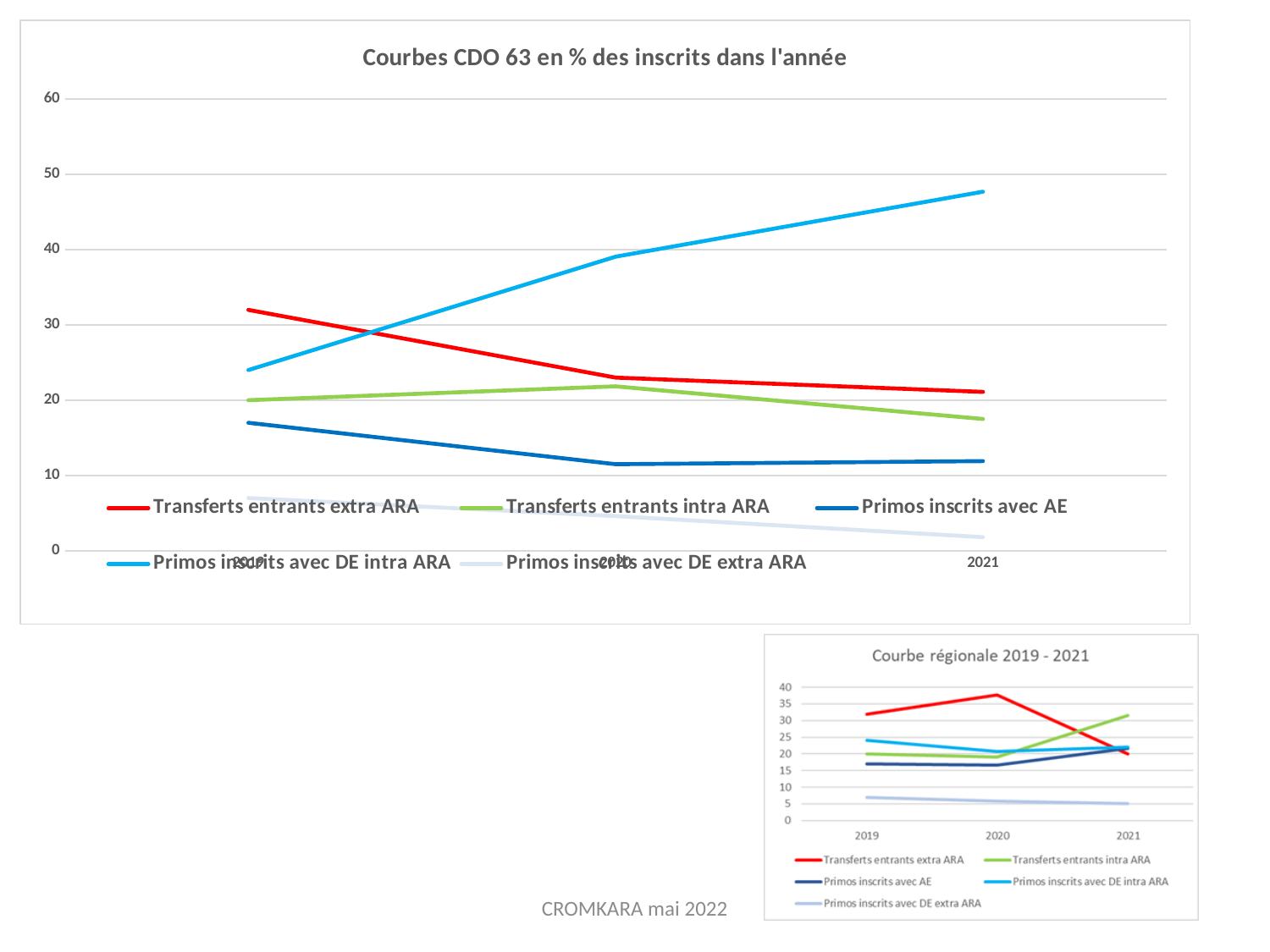
In the small chart 'Courbe régionale 2019 - 2021', which series has the highest value in 2021? Transferts entrants intra ARA In the chart 'Courbes CDO 63 en % des inscrits dans l'année', which series has the lowest value in 2021? Primos inscrits avec DE extra ARA In the small chart 'Courbe régionale 2019 - 2021', which series has the highest value in 2020? Transferts entrants extra ARA What kind of chart is the large chart titled 'Courbes CDO 63 en % des inscrits dans l'année'? line chart In the chart 'Courbes CDO 63 en % des inscrits dans l'année', how many series does the legend list? 5 In the chart 'Courbes CDO 63 en % des inscrits dans l'année', is the value for 'Transferts entrants extra ARA' in 2019 greater or less than 30? greater In the chart 'Courbes CDO 63 en % des inscrits dans l'année', does the 'Transferts entrants extra ARA' line rise or fall from 2019 to 2021? fall In the chart 'Courbes CDO 63 en % des inscrits dans l'année', is the value for 'Primos inscrits avec DE intra ARA' in 2021 greater or less than 40? greater In the chart 'Courbes CDO 63 en % des inscrits dans l'année', which is larger in 2019: 'Transferts entrants extra ARA' or 'Primos inscrits avec DE intra ARA'? Transferts entrants extra ARA In the chart 'Courbes CDO 63 en % des inscrits dans l'année', which series has the highest value in 2021? Primos inscrits avec DE intra ARA In the chart 'Courbes CDO 63 en % des inscrits dans l'année', how many years are shown on the x axis? 3 In the chart 'Courbes CDO 63 en % des inscrits dans l'année', does the 'Primos inscrits avec DE intra ARA' line rise or fall from 2019 to 2021? rise